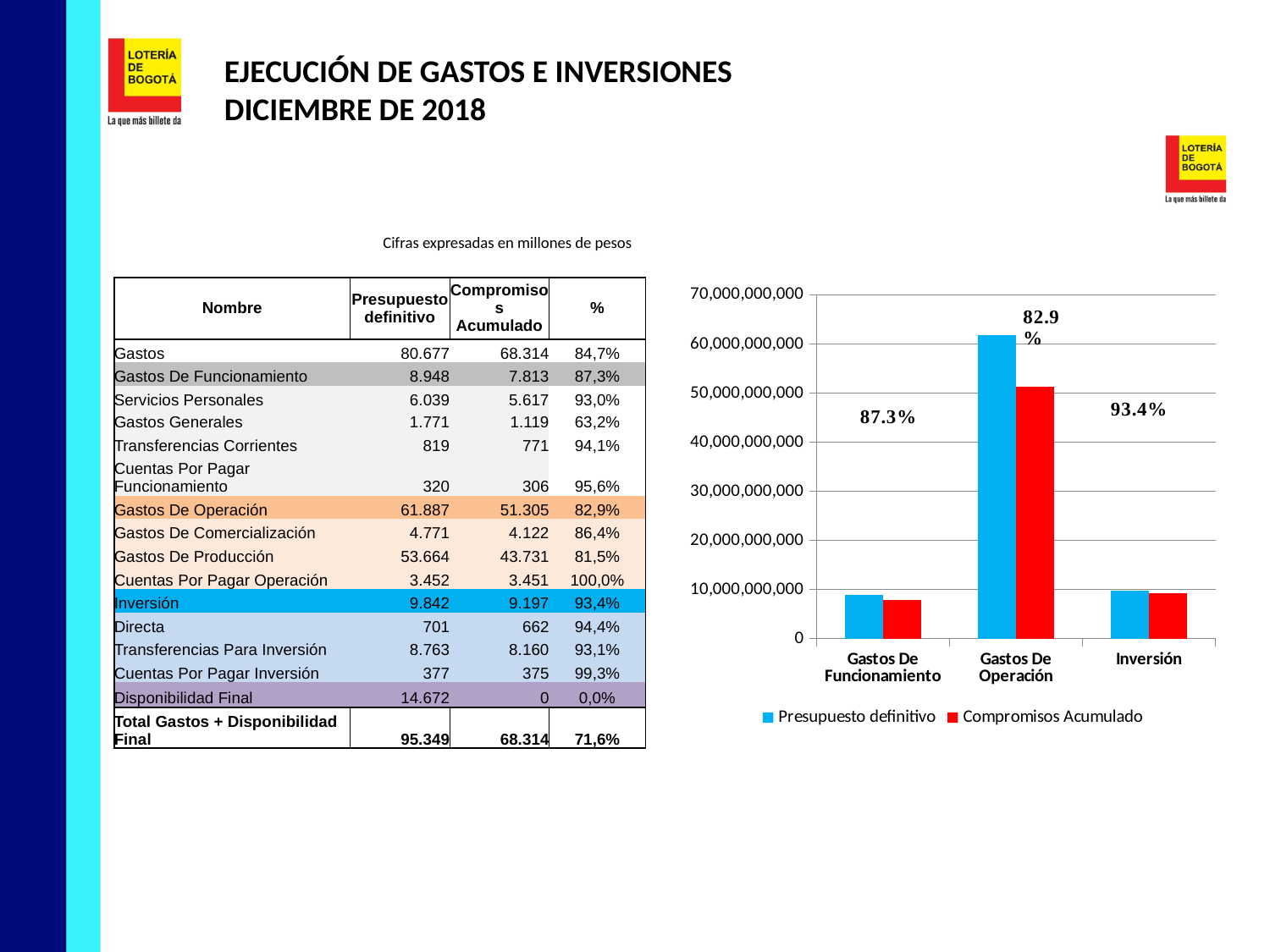
What kind of chart is shown on the right of the slide? bar chart What percentage label is shown above the bars for Gastos De Operación? 82.9% Which series is shown in red in the chart? Compromisos Acumulado Which category has the tallest Presupuesto definitivo bar? Gastos De Operación How many categories are shown on the x axis of the chart? 3 What percentage label is shown above the bars for Gastos De Funcionamiento? 87.3% What is the difference between the percentage labels for Inversión and Gastos De Operación? 10.5% Is the Presupuesto definitivo bar for Gastos De Operación greater or less than 50,000,000,000? greater How many series does the chart legend list? 2 What percentage label is shown above the bars for Inversión? 93.4% Is the Compromisos Acumulado bar for Gastos De Funcionamiento greater or less than 10,000,000,000? less Which category has the lowest percentage label in the chart? Gastos De Operación